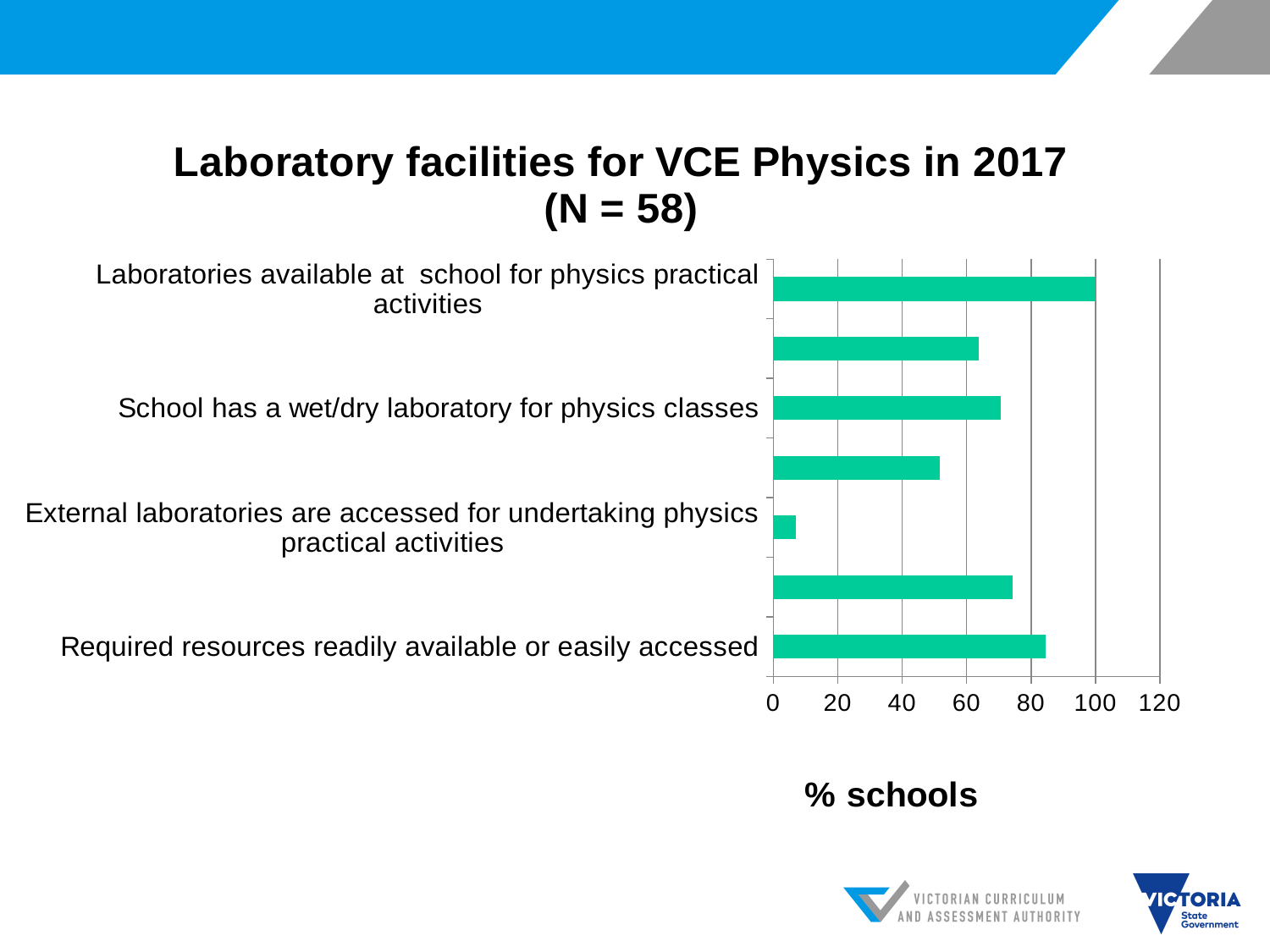
How many bars are plotted in the chart? 7 What is the label of the horizontal axis? % schools What is the title of the chart? Laboratory facilities for VCE Physics in 2017 (N = 58) Is the value for "External laboratories are accessed for undertaking physics practical activities" greater or less than 20? less Is the value for "School has a wet/dry laboratory for physics classes" greater or less than 60? greater Is the value for "Laboratories available at school for physics practical activities" greater or less than 80? greater Which is larger: the value for "External laboratories are accessed for undertaking physics practical activities" or the value for "School has a wet/dry laboratory for physics classes"? School has a wet/dry laboratory for physics classes Which labelled category has the shortest bar? External laboratories are accessed for undertaking physics practical activities What kind of chart is shown on the slide? bar chart Which is larger: the value for "Required resources readily available or easily accessed" or the value for "School has a wet/dry laboratory for physics classes"? Required resources readily available or easily accessed Which labelled category has the longest bar? Laboratories available at school for physics practical activities